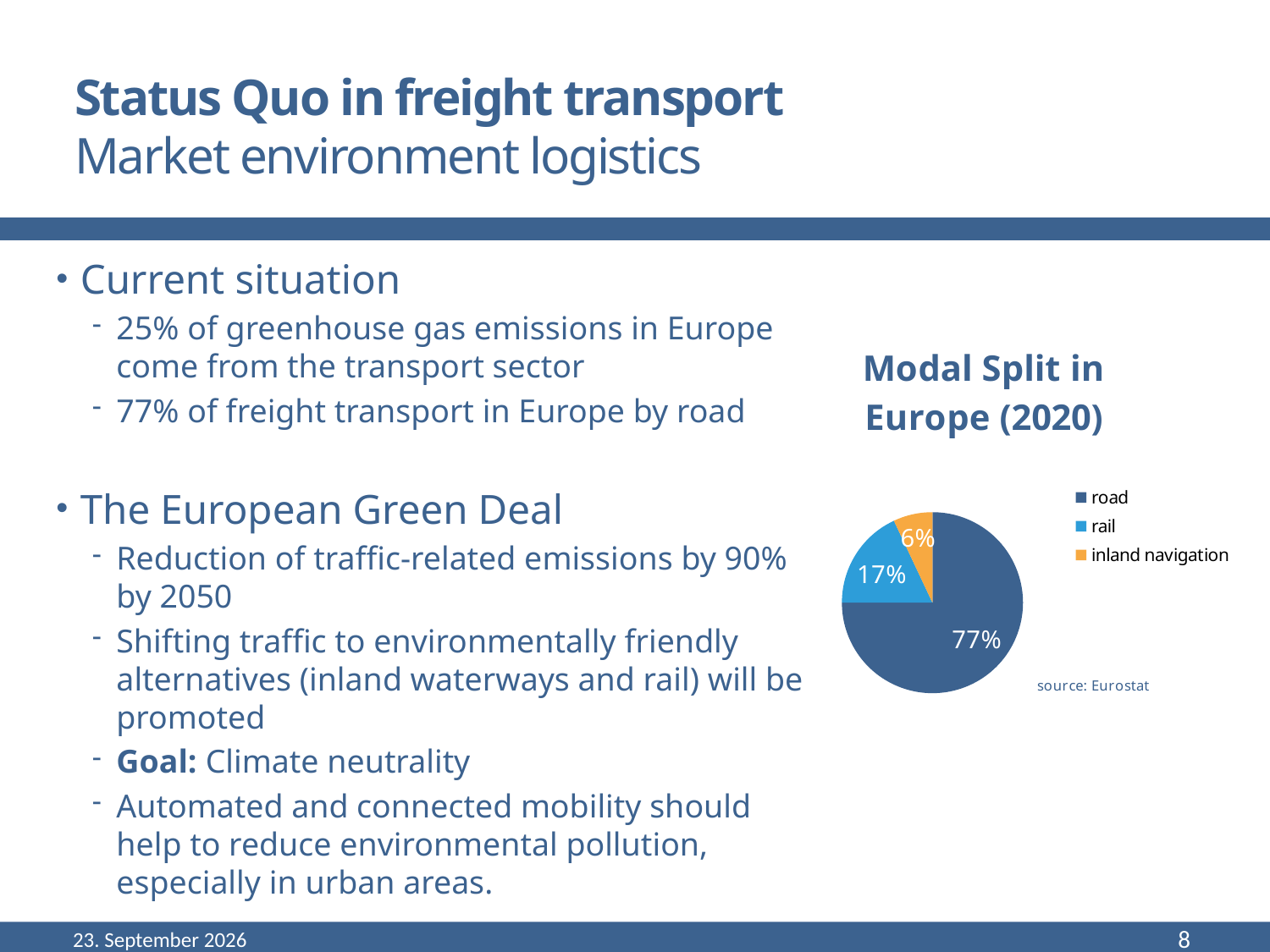
What is the title of the chart? Modal Split in Europe (2020) What share of the pie does inland navigation account for? 6% How many categories does the pie chart show? 3 Which is larger, the rail share or the inland navigation share? rail Which category has the smallest slice of the pie? inland navigation How many entries does the legend list? 3 What is the difference in percentage points between the road share and the rail share? 60 What source is cited for the chart? Eurostat What kind of chart is shown on the slide? pie chart Which category has the largest slice of the pie? road What share of the pie does rail account for? 17% What share of the pie does road account for? 77%